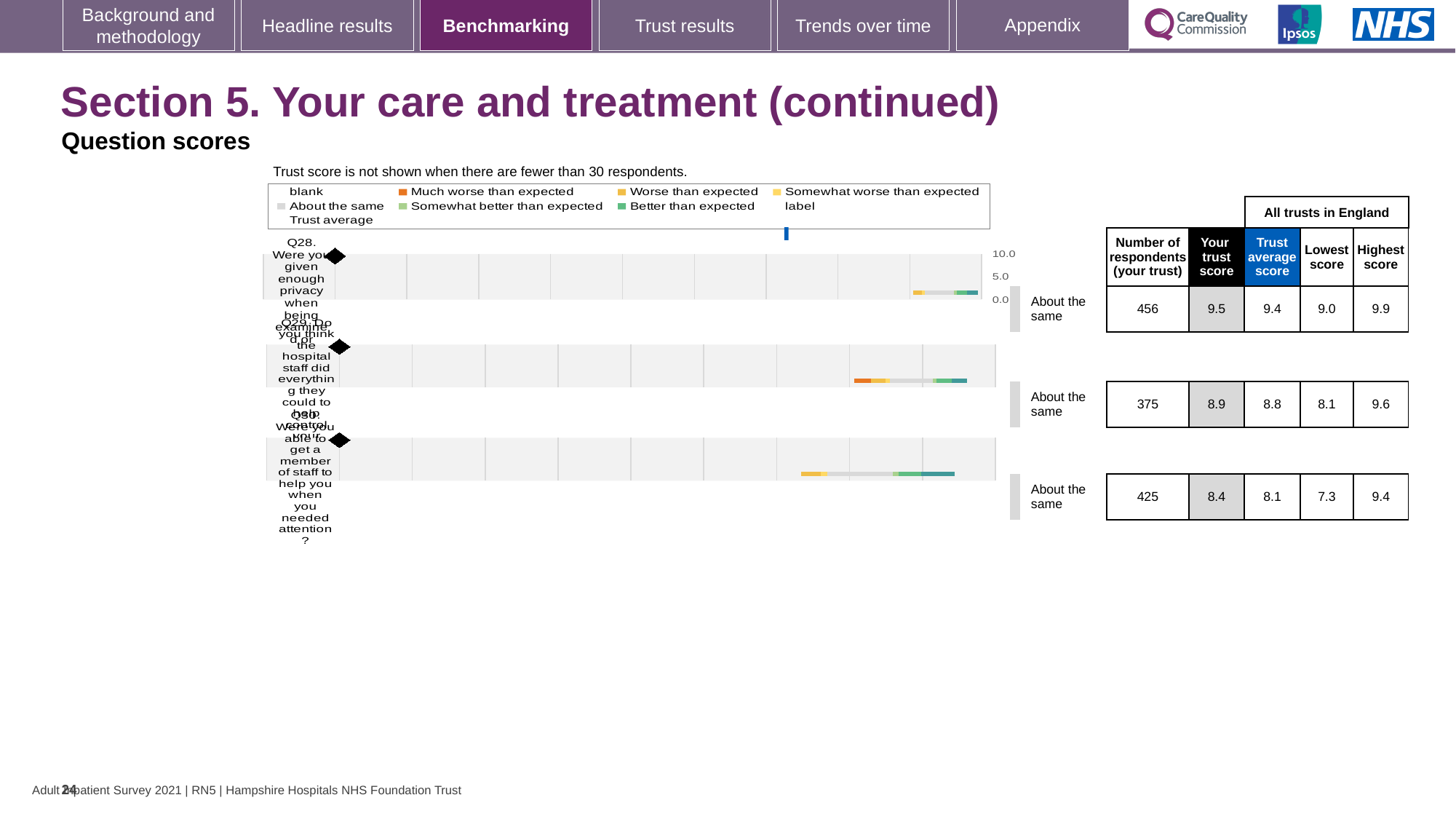
What benchmark category label is shown next to each of the three questions in the chart? About the same Which question has the lowest trust score: Q28, Q29 or Q30? Q30 Is the trust score for Q28 greater or less than 5.0 on the chart axis? greater Which question has the highest trust score: Q28, Q29 or Q30? Q28 For Q30, which is larger: the trust score or the trust average score? the trust score (8.4) What is the difference between the trust score and the trust average score for Q28? 0.1 How many questions are plotted in the question scores chart? 3 What is the trust score for Q28 (Were you given enough privacy when being examined or treated)? 9.5 How many respondents answered Q29 for this trust? 375 What is the difference between the highest score and the lowest score for Q29? 1.5 What kind of chart is used to show the question scores on this slide? bar chart What is the highest score across all trusts in England for Q30? 9.4